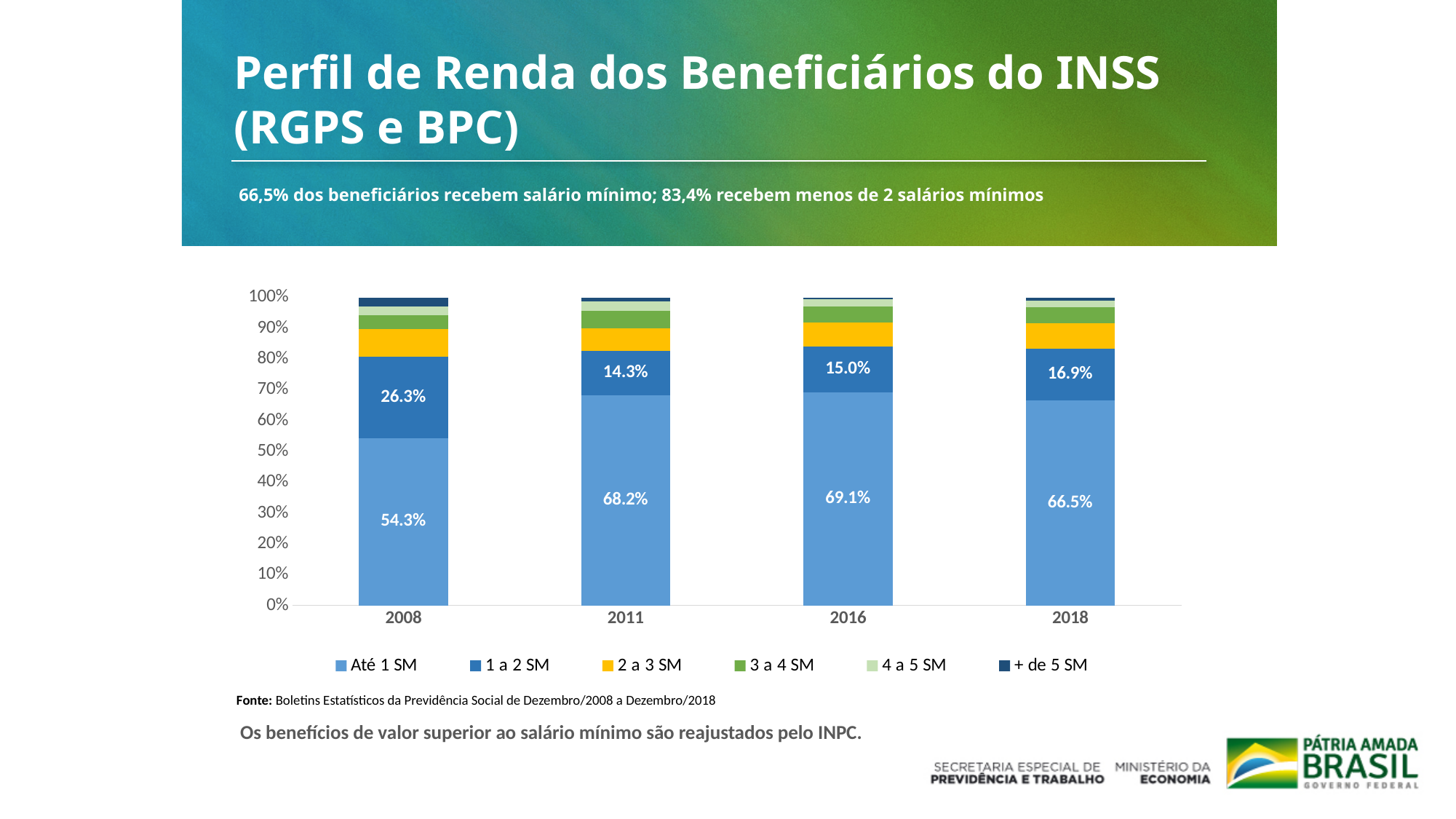
In which year is the Até 1 SM share highest? 2016 What is the value for Até 1 SM in 2016? 69.1% How many series does the legend list? 6 Which is larger: the 1 a 2 SM share in 2008 or in 2016? 2008 How many years are shown on the x axis? 4 Does the Até 1 SM share rise or fall from 2008 to 2011? rise What is the difference between the Até 1 SM share in 2016 and in 2008? 14.8 percentage points What is the value for 1 a 2 SM in 2018? 16.9% What is the value for Até 1 SM in 2008? 54.3% What kind of chart is shown on the slide? stacked bar chart What is the value for 1 a 2 SM in 2011? 14.3% In which year is the 1 a 2 SM share lowest? 2011